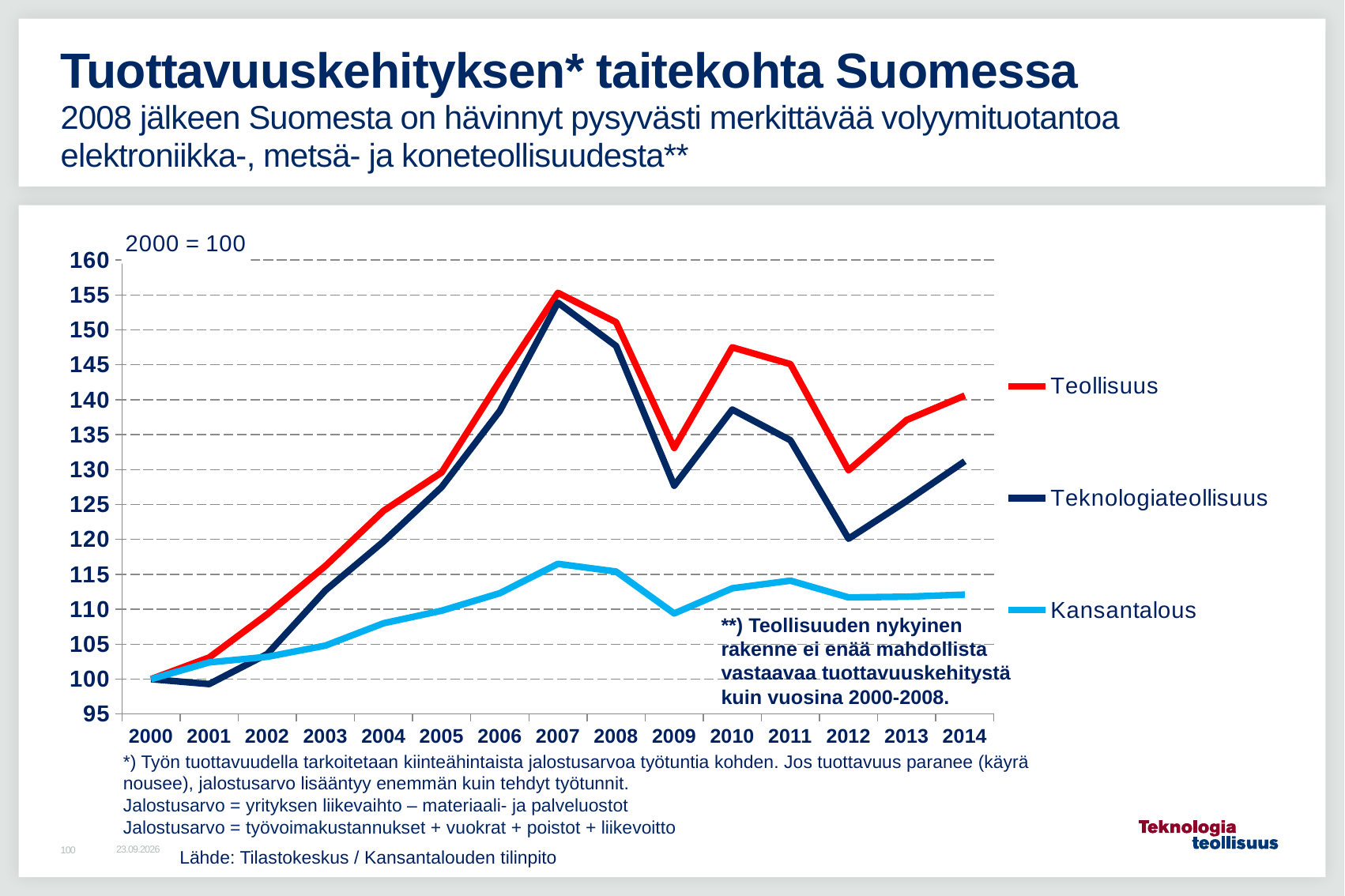
Is the value for Teknologiateollisuus in 2009 greater or less than 125? greater How many series does the legend list? 3 Which series has the lowest value in 2014? Kansantalous What kind of chart is shown on the slide? line chart Does the Teknologiateollisuus series rise or fall from 2000 to 2007? rise Is the value for Kansantalous in 2014 greater or less than 110? greater What is the index value of all three series in 2000? 100 In which year does the Teollisuus series reach its highest value? 2007 Which is larger in 2012, Teollisuus or Teknologiateollisuus? Teollisuus Is the value for Teollisuus in 2007 greater or less than 150? greater How many years are shown on the x axis? 15 What colour is the Kansantalous line in the legend? light blue